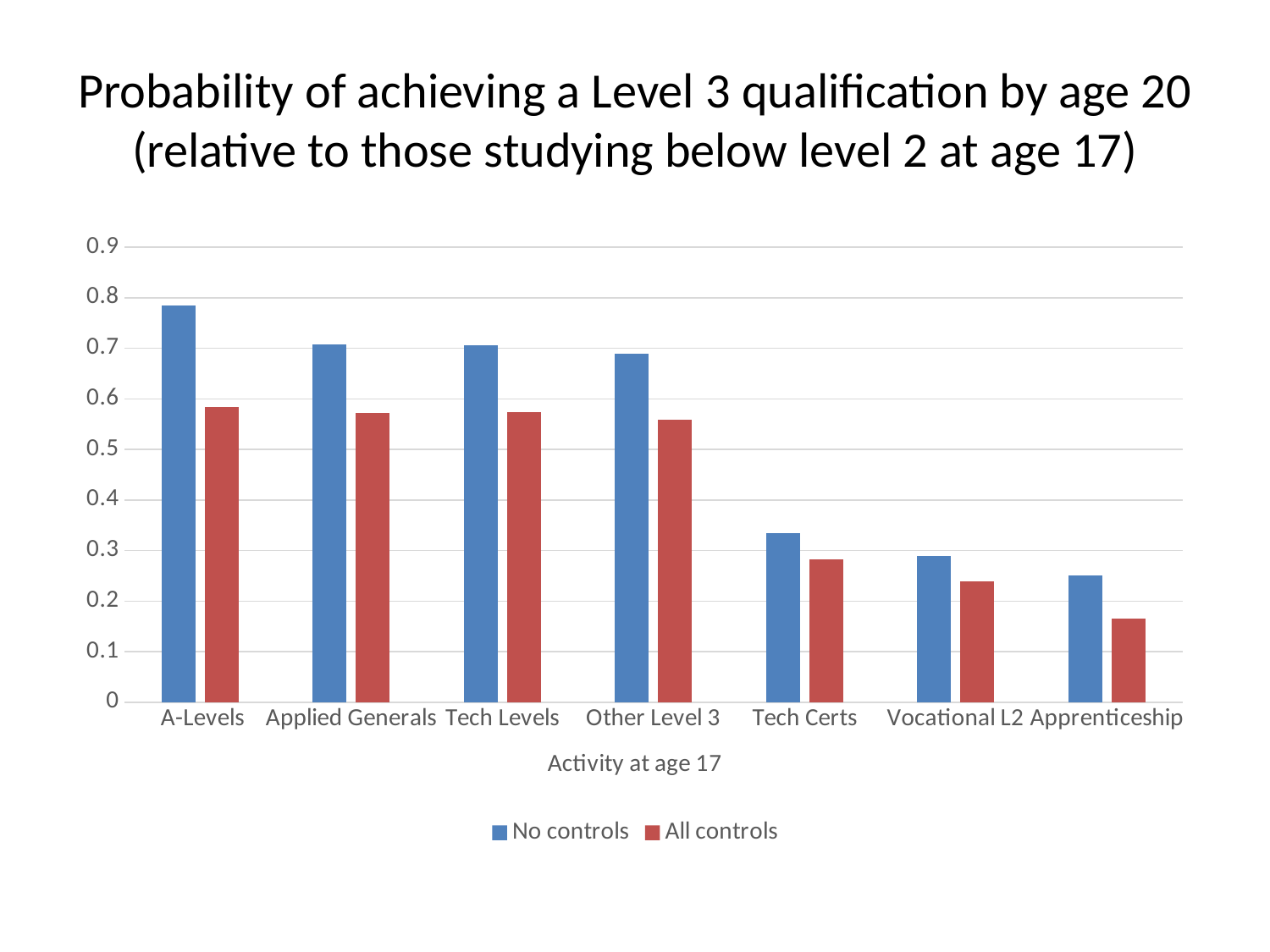
Which category has the lowest value for the All controls series? Apprenticeship For A-Levels, which series has the larger value, No controls or All controls? No controls Is the All controls value for Apprenticeship greater or less than 0.2? less Which category has the lowest value for the No controls series? Apprenticeship How many categories are shown on the x axis? 7 Do the No controls values generally rise or fall moving from left to right along the x axis? fall How many series does the legend list? 2 What kind of chart is shown on the slide? bar chart What is the title of the x axis? Activity at age 17 Is the No controls value for Tech Certs greater or less than 0.4? less Is the No controls value for A-Levels greater or less than 0.7? greater Which category has the highest value for the No controls series? A-Levels